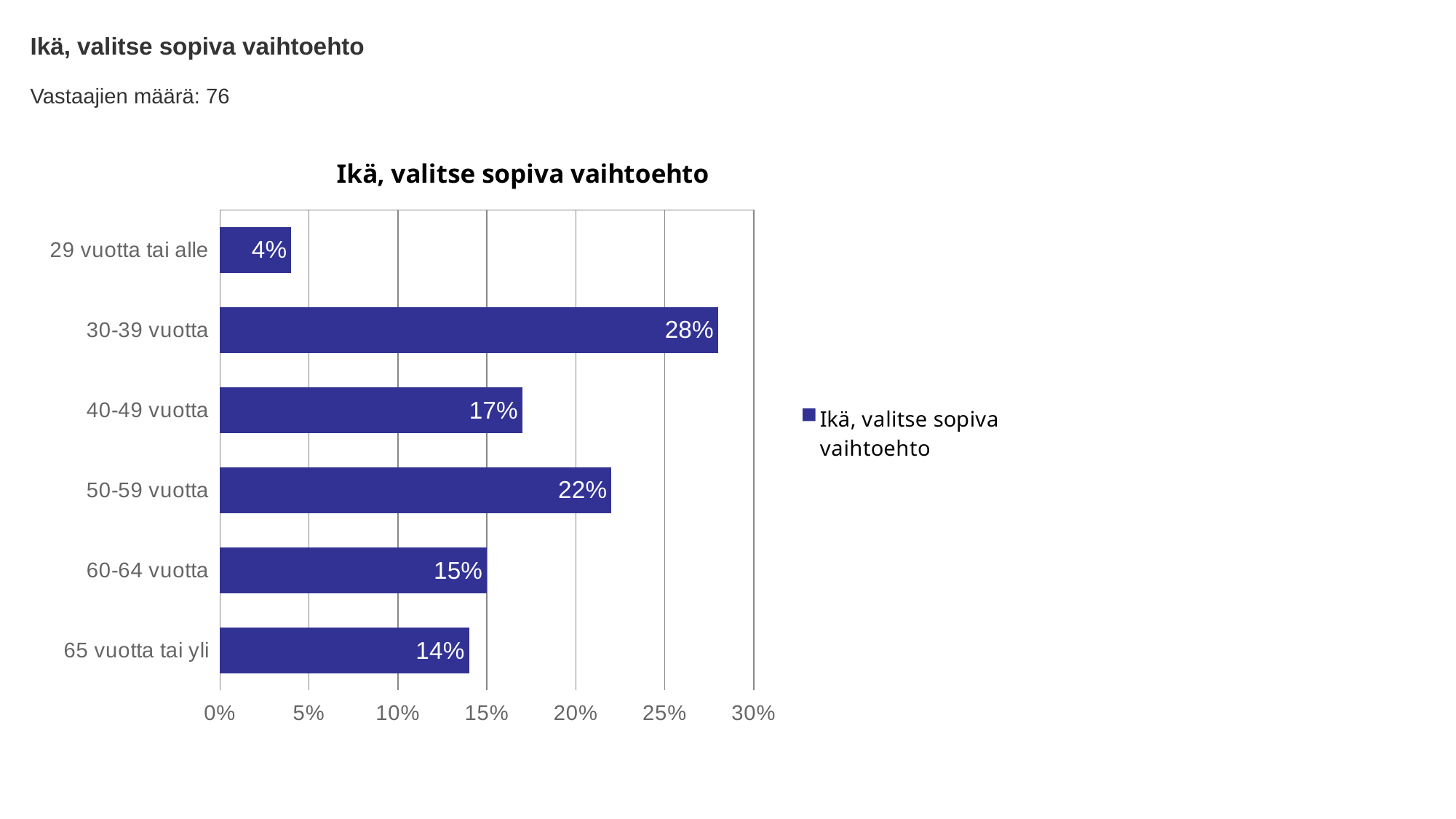
What is the value for 65 vuotta tai yli? 14% What is the title of the chart? Ikä, valitse sopiva vaihtoehto What is the value for 29 vuotta tai alle? 4% Which age category has the highest value? 30-39 vuotta How many series does the legend list? 1 Which is larger, the value for 40-49 vuotta or the value for 60-64 vuotta? 40-49 vuotta What is the difference between the values for 30-39 vuotta and 50-59 vuotta? 6% What is the value for 30-39 vuotta? 28% What kind of chart is shown on the slide? bar chart Which age category has the lowest value? 29 vuotta tai alle How many age categories are shown in the chart? 6 Is the value for 50-59 vuotta greater or less than 20%? greater